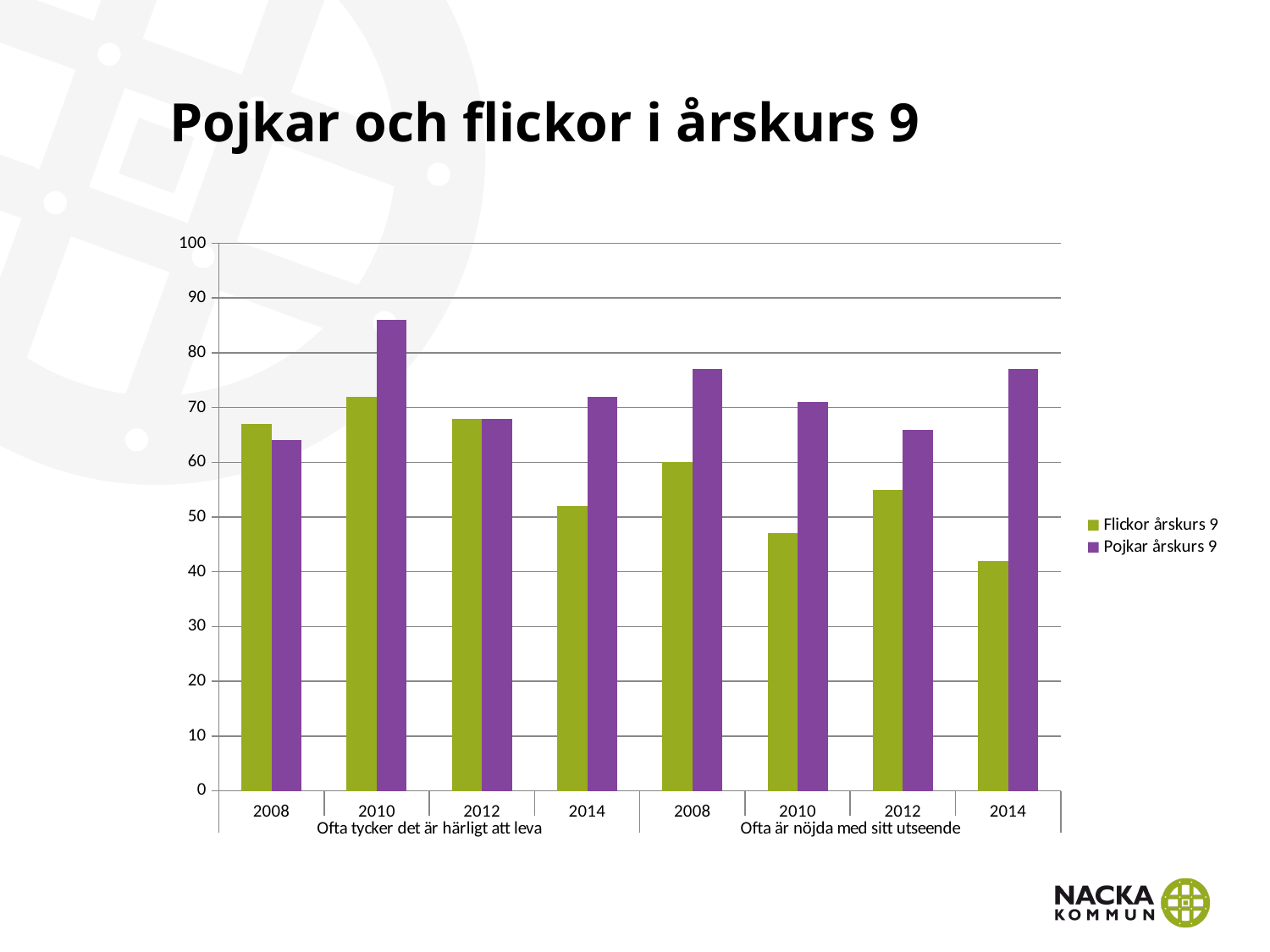
What kind of chart is shown on the slide? bar chart Is the value for Pojkar årskurs 9 in 2010 under 'Ofta tycker det är härligt att leva' greater or less than 80? greater Under 'Ofta tycker det är härligt att leva' in 2008, which is larger: Flickor årskurs 9 or Pojkar årskurs 9? Flickor årskurs 9 Is the value for Flickor årskurs 9 in 2014 under 'Ofta är nöjda med sitt utseende' greater or less than 50? less Which series is shown in purple? Pojkar årskurs 9 Under 'Ofta är nöjda med sitt utseende' in 2014, which is larger: Flickor årskurs 9 or Pojkar årskurs 9? Pojkar årskurs 9 In which year and group does Flickor årskurs 9 have its lowest value? 2014, Ofta är nöjda med sitt utseende Do the values for Flickor årskurs 9 under 'Ofta är nöjda med sitt utseende' rise or fall from 2008 to 2014 overall? fall How many year categories are shown on the x axis in total? 8 Is the value for Flickor årskurs 9 in 2010 under 'Ofta är nöjda med sitt utseende' greater or less than 50? less In which year and group does Pojkar årskurs 9 reach its highest value? 2010, Ofta tycker det är härligt att leva How many series does the legend list? 2